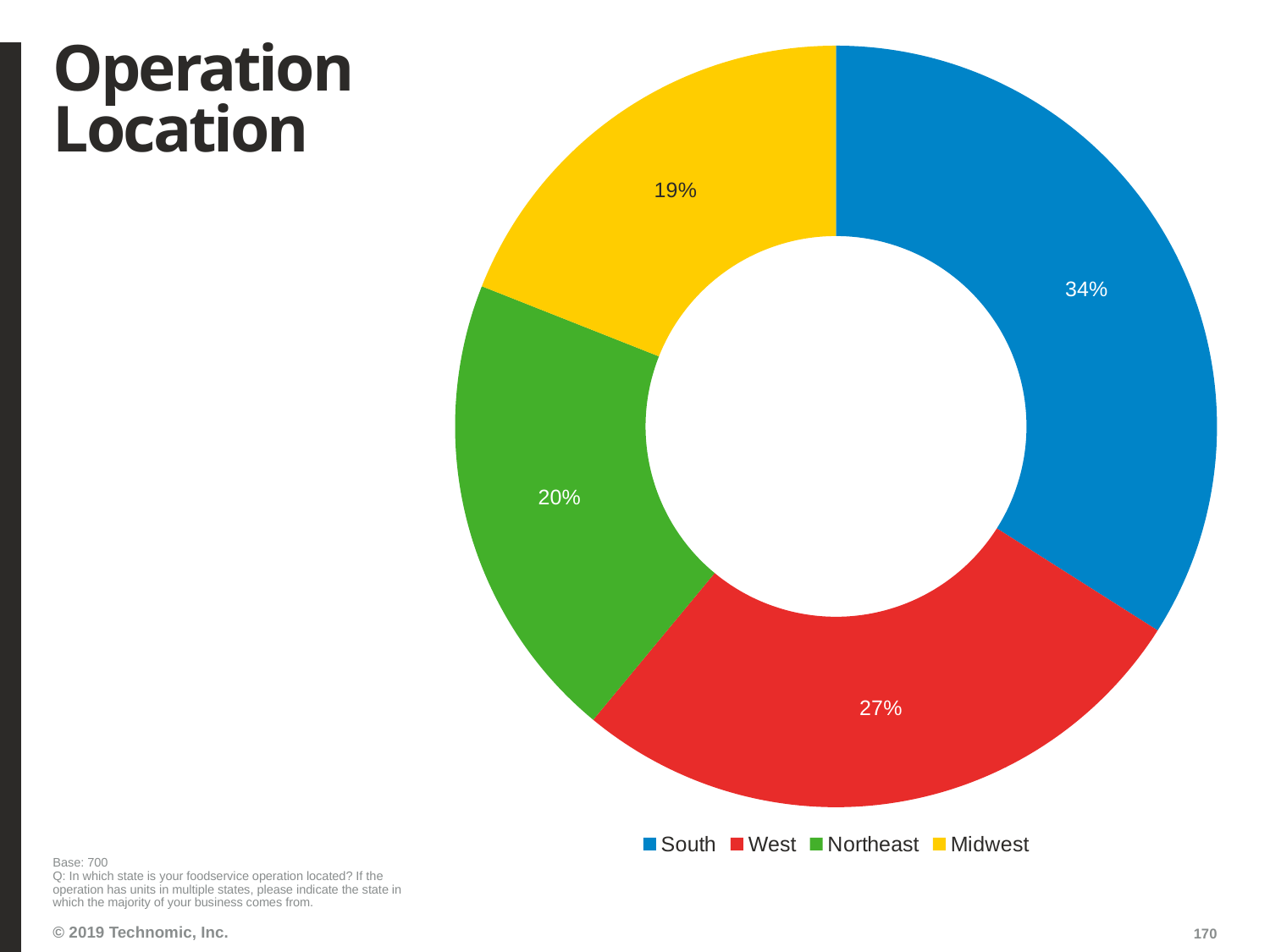
Which region has the smallest share of operations? Midwest What share of operations are located in the West? 27% Which region has the largest share of operations? South What is the difference in percentage points between the Northeast and the Midwest shares? 1 What is the difference in percentage points between the South and the West shares? 7 What colour represents the Midwest in the chart? Yellow What share of operations are located in the Midwest? 19% What share of operations are located in the South? 34% What kind of chart is shown on the slide? Pie chart (doughnut) How many regions are shown in the chart? 4 Which has a larger share, the West or the Northeast? West What share of operations are located in the Northeast? 20%